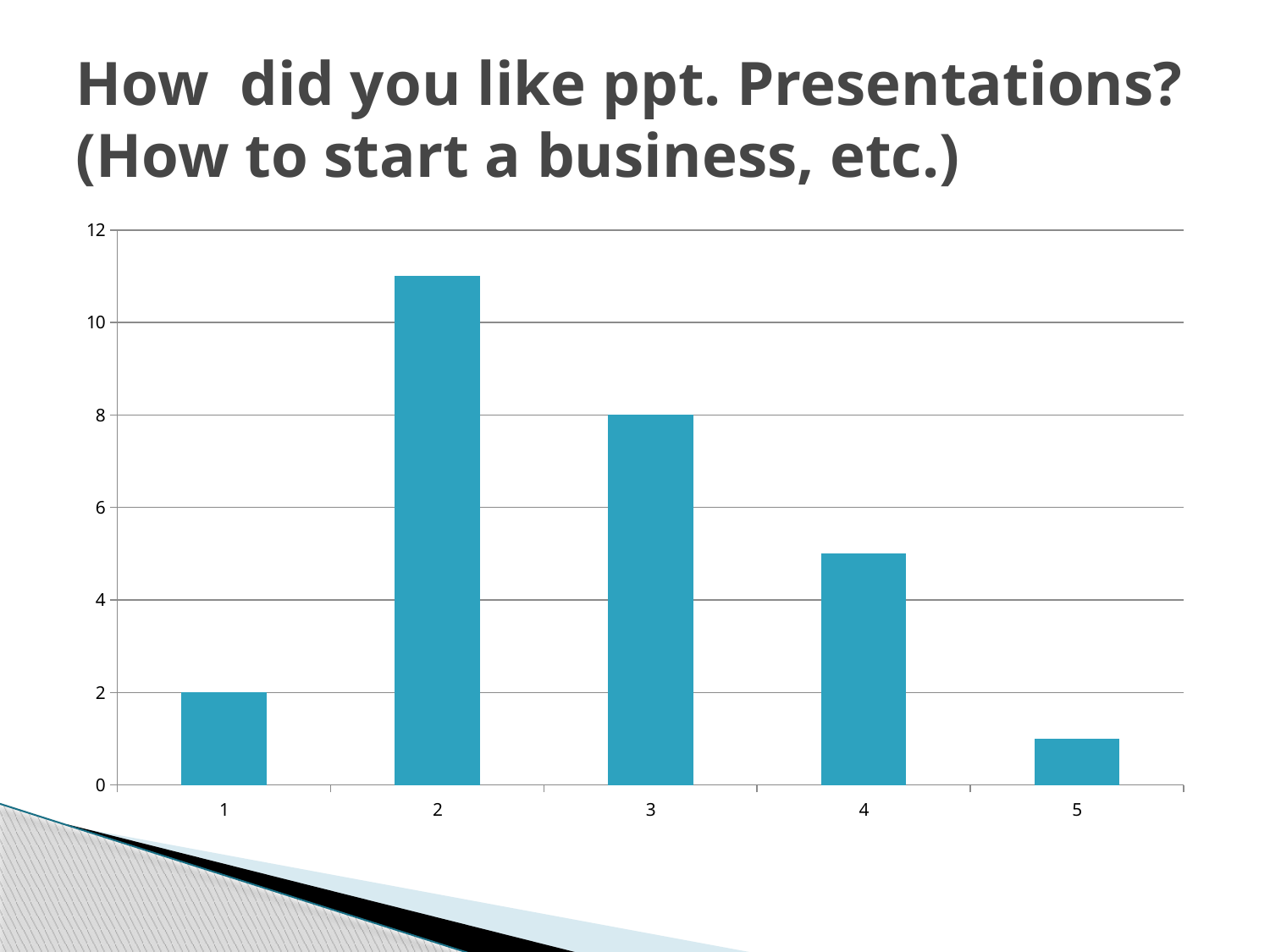
What is the difference between the values for category 3 and category 1? 6 What is the value for category 3? 8 Which category has the lowest bar? 5 How many categories are shown on the x axis of the chart? 5 Is the value for category 4 greater or less than 6? less What is the value for category 1? 2 Which category has the highest bar? 2 What type of chart is shown on the slide? bar chart Which is larger, the value for category 2 or the value for category 4? 2 What is the title of the slide containing the chart? How did you like ppt. Presentations? (How to start a business, etc.) Is the value for category 2 greater or less than 10? greater Is the value for category 5 greater or less than 2? less